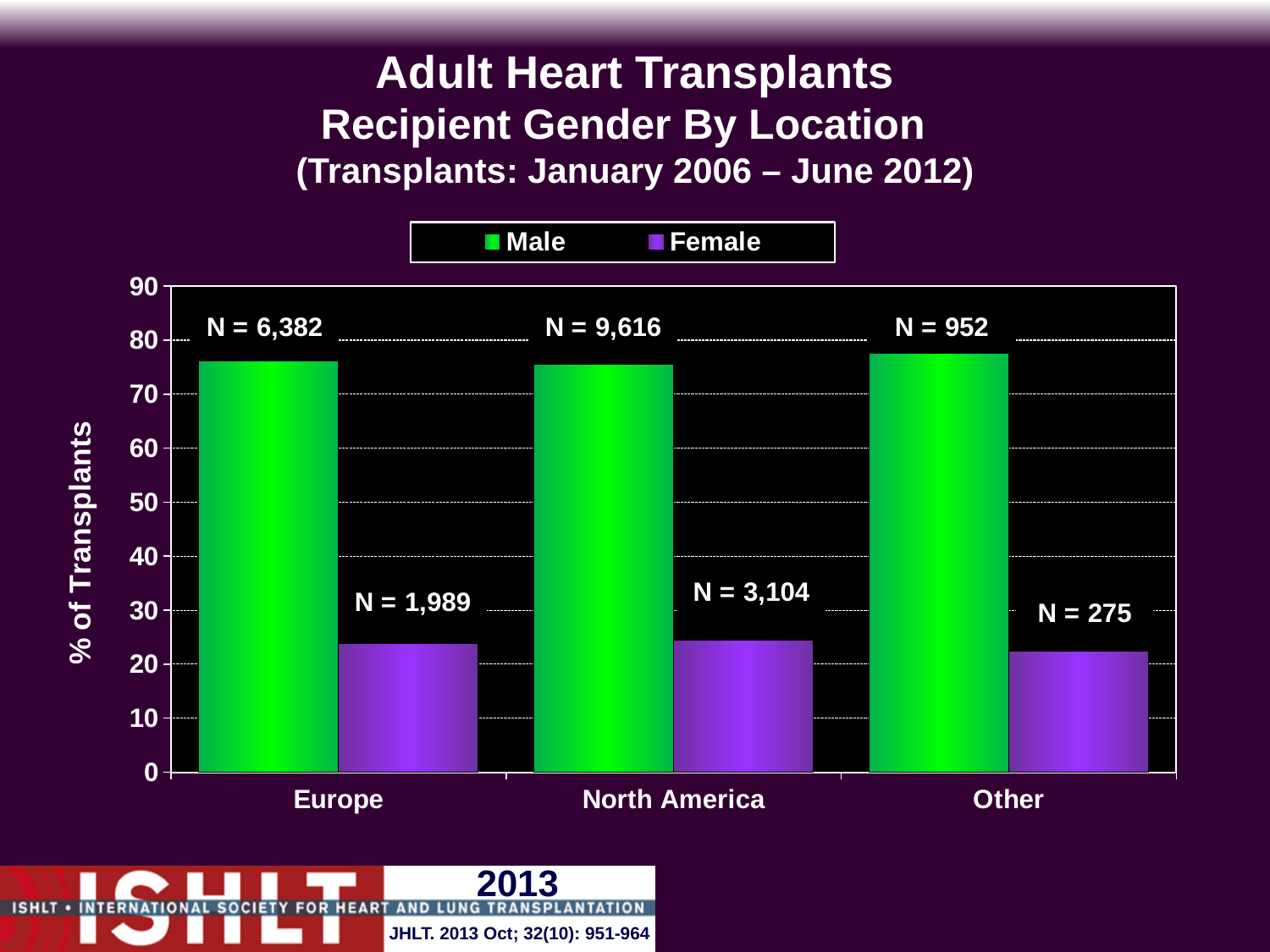
Is the value for Female in Europe greater or less than 30? less What is the N value printed above the Male bar for Europe? N = 6,382 What is the N value printed above the Female bar for North America? N = 3,104 Which bar has the smallest N value printed above it? Female, Other How many location categories are shown on the x axis? 3 For Europe, which is larger, the Male bar or the Female bar? Male What is the difference between the N values for Male in North America and Male in Europe? 3,234 Is the value for Male in Other greater or less than 70? greater What kind of chart is shown on the slide? bar chart Which bar has the largest N value printed above it? Male, North America What is the N value printed above the Female bar for Other? N = 275 How many series does the legend list? 2